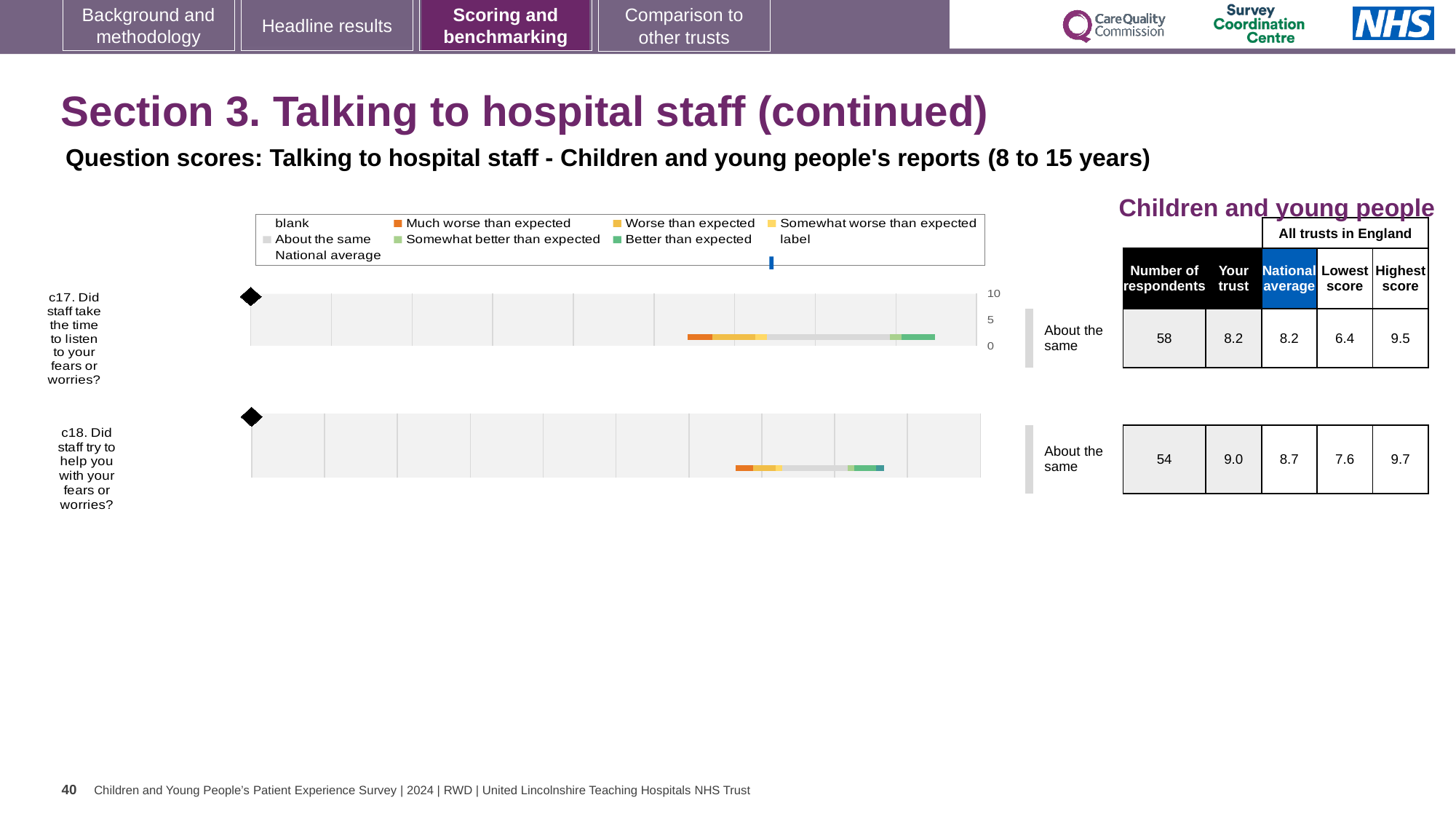
What is the highest score across all trusts in England for question c17? 9.5 What is the 'Your trust' score for question c17 (Did staff take the time to listen to your fears or worries?)? 8.2 What is the 'Your trust' score for question c18 (Did staff try to help you with your fears or worries?)? 9.0 What is the difference between the highest and lowest scores for question c17? 3.1 What is the lowest score across all trusts in England for question c18? 7.6 What benchmark category is shown next to the chart for question c18? About the same Which question has the higher 'Your trust' score, c17 or c18? c18 How many survey questions are plotted on the slide? 2 By how much does the trust's score for c18 exceed the national average for c18? 0.3 How many respondents answered question c17? 58 Is the trust's score for question c17 greater or less than 5 on the chart axis? greater What is the national average score for question c18? 8.7